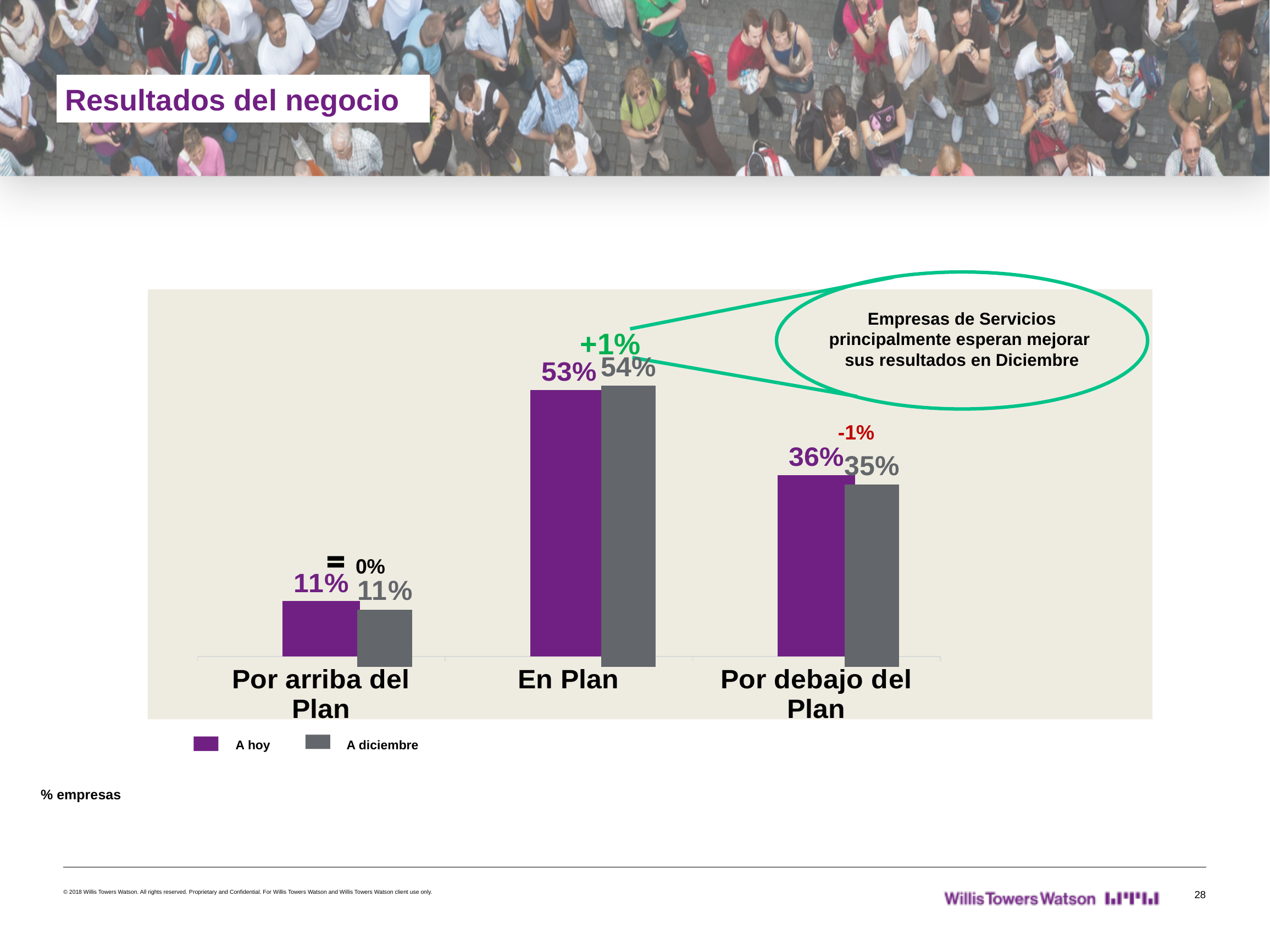
What change is annotated above the 'En Plan' bars? +1% What are the two series listed in the legend? A hoy, A diciembre How many categories are shown on the x axis? 3 Which is larger for 'Por debajo del Plan': the 'A hoy' value or the 'A diciembre' value? A hoy Which category has the lowest value in the 'A hoy' series? Por arriba del Plan Which category has the highest value in the 'A diciembre' series? En Plan What is the difference between the 'A hoy' values for 'En Plan' and 'Por debajo del Plan'? 17% What kind of chart is shown on the slide? Bar chart What is the value for 'Por arriba del Plan' in the 'A hoy' series? 11% What is the value for 'En Plan' in the 'A hoy' series? 53% What is the value for 'Por debajo del Plan' in the 'A diciembre' series? 35% How many series does the legend list? 2